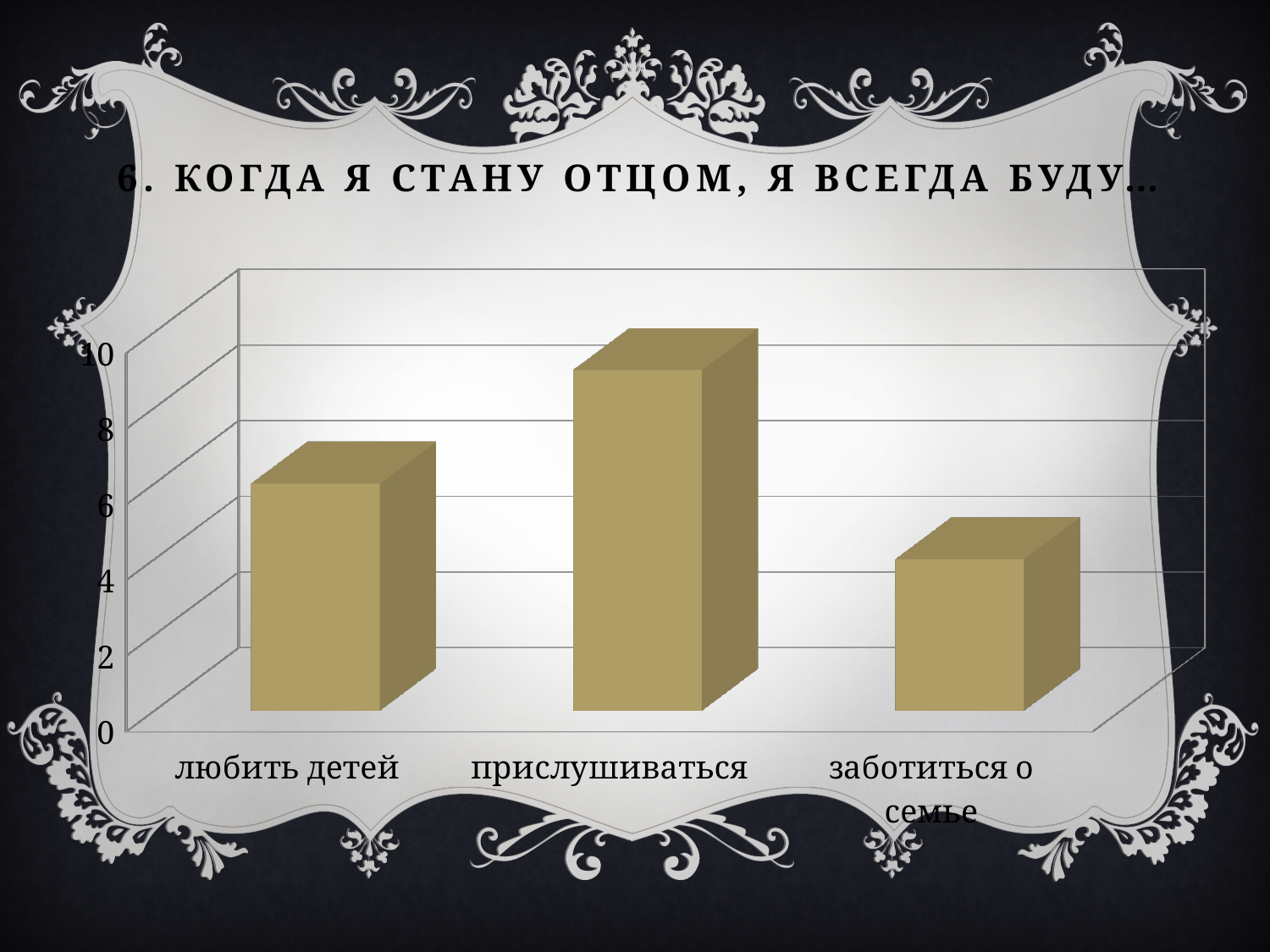
Which is larger, the value for "прислушиваться" or the value for "любить детей"? прислушиваться What is the title of the slide above the chart? 6. Когда я стану отцом, я всегда буду… Is the value for "заботиться о семье" greater or less than 2? greater Which is larger, the value for "любить детей" or the value for "заботиться о семье"? любить детей Which category has the highest bar? прислушиваться Is the value for "заботиться о семье" greater or less than 6? less Which category has the lowest bar? заботиться о семье What is the highest value shown on the vertical axis? 10 How many categories are shown on the chart? 3 What kind of chart is shown on the slide? bar chart Is the value for "прислушиваться" greater or less than 8? greater